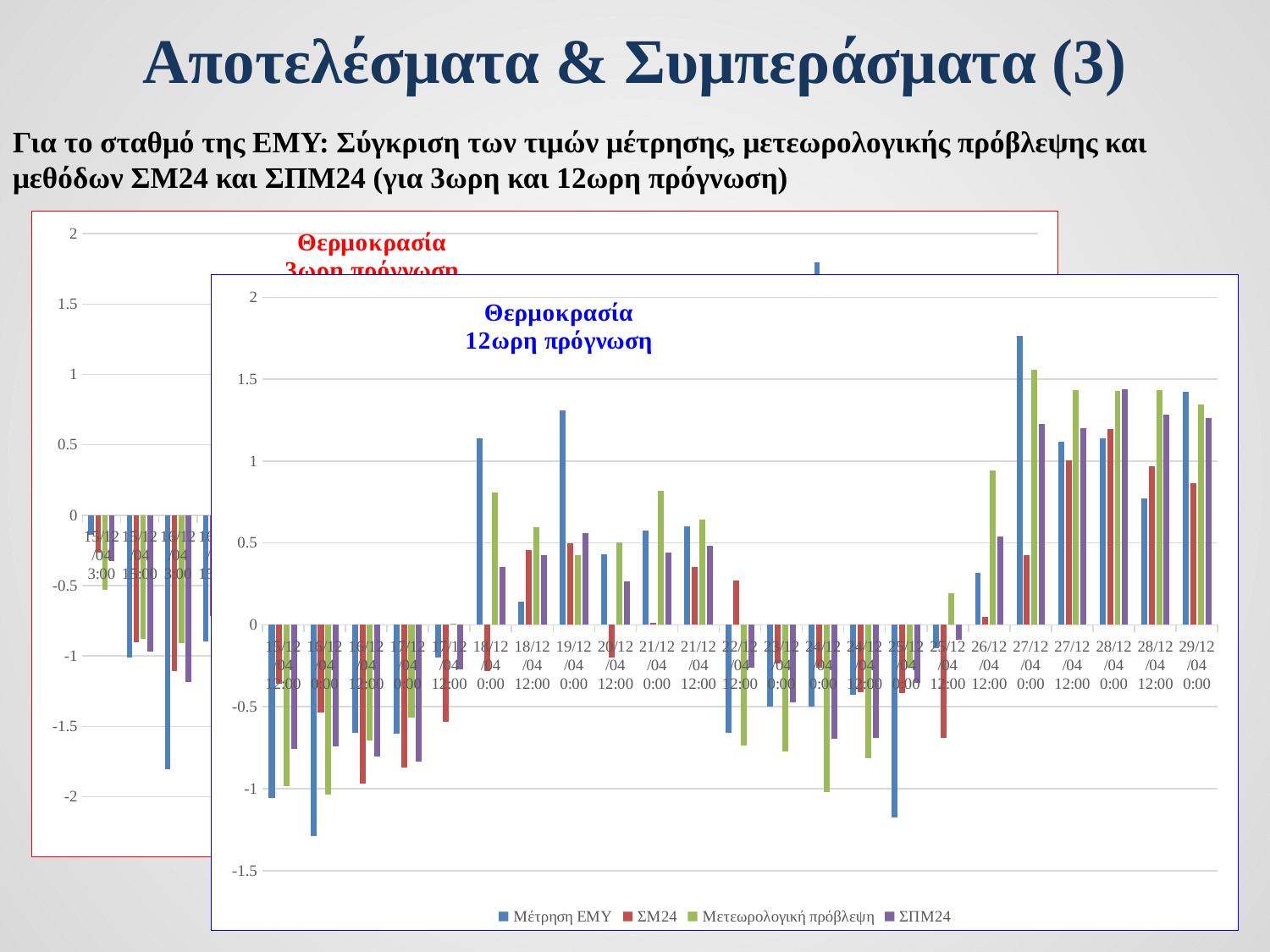
In the 'Θερμοκρασία 12ωρη πρόγνωση' chart, is the Μέτρηση ΕΜΥ value at 19/12/04 0:00 greater or less than 1? greater In the 'Θερμοκρασία 12ωρη πρόγνωση' chart, is the Μέτρηση ΕΜΥ value at 16/12/04 0:00 greater or less than -1? less How many series does the legend of the 'Θερμοκρασία 12ωρη πρόγνωση' chart list? 4 How many date/time categories are shown on the x axis of the 'Θερμοκρασία 12ωρη πρόγνωση' chart? 23 What is the title of the chart in front, on the right side of the slide? Θερμοκρασία 12ωρη πρόγνωση In the 'Θερμοκρασία 12ωρη πρόγνωση' chart, which series is shown in green according to the legend? Μετεωρολογική πρόβλεψη In the 'Θερμοκρασία 12ωρη πρόγνωση' chart, at 18/12/04 0:00, which is larger: the Μέτρηση ΕΜΥ value or the ΣΜ24 value? Μέτρηση ΕΜΥ In the 'Θερμοκρασία 12ωρη πρόγνωση' chart, is the ΣΜ24 value at 19/12/04 0:00 greater or less than 1? less In the 'Θερμοκρασία 12ωρη πρόγνωση' chart, at which date/time does the Μέτρηση ΕΜΥ series reach its highest value? 27/12/04 0:00 What kind of chart is the 'Θερμοκρασία 12ωρη πρόγνωση' chart? bar chart